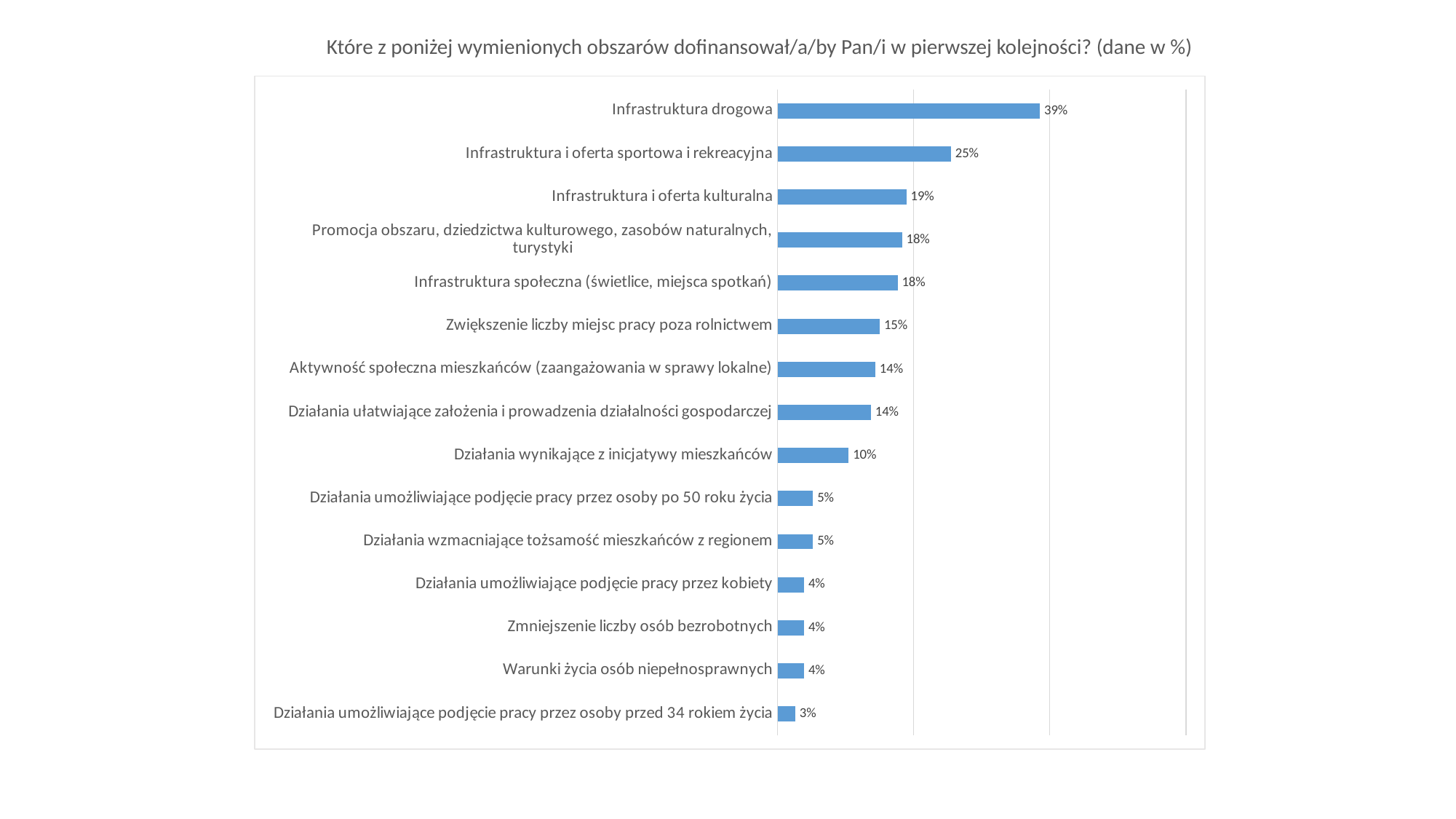
What is the value for Działania wynikające z inicjatywy mieszkańców? 10% How many categories are shown in the chart? 15 What kind of chart is shown on the slide? Bar chart What is the title of the chart? Które z poniżej wymienionych obszarów dofinansował/a/by Pan/i w pierwszej kolejności? (dane w %) What is the value for Infrastruktura drogowa? 39% Which category has the lowest value? Działania umożliwiające podjęcie pracy przez osoby przed 34 rokiem życia What is the value for Infrastruktura i oferta sportowa i rekreacyjna? 25% What is the value for Zwiększenie liczby miejsc pracy poza rolnictwem? 15% Which is larger: the value for Infrastruktura i oferta kulturalna or the value for Zwiększenie liczby miejsc pracy poza rolnictwem? Infrastruktura i oferta kulturalna What is the difference between the values for Działania wynikające z inicjatywy mieszkańców and Działania umożliwiające podjęcie pracy przez kobiety? 6% Which category has the highest value? Infrastruktura drogowa What is the difference between the values for Infrastruktura drogowa and Infrastruktura i oferta sportowa i rekreacyjna? 14%